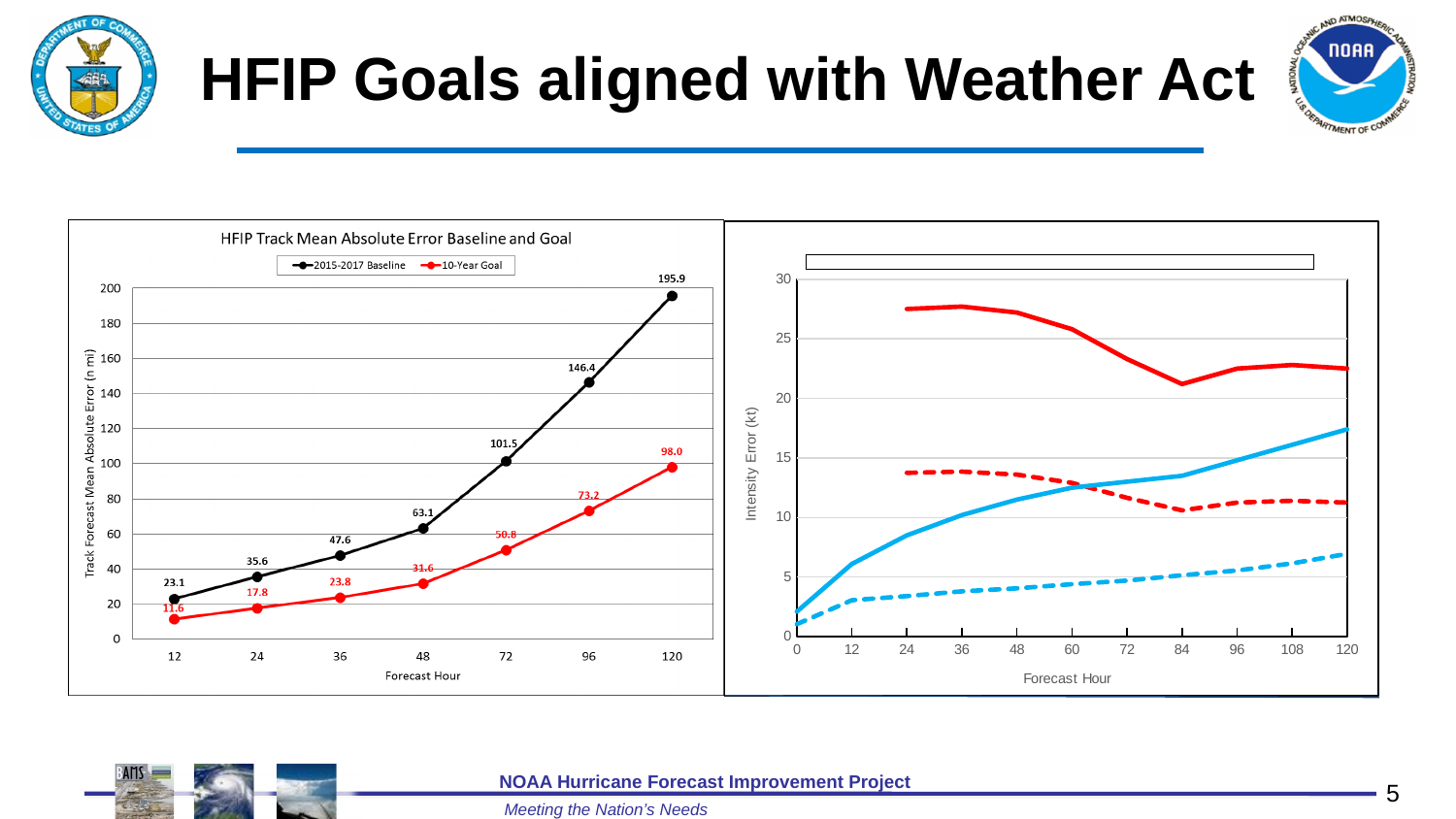
On the left chart titled 'HFIP Track Mean Absolute Error Baseline and Goal', does the 2015-2017 Baseline rise or fall as the forecast hour increases? rise On the left chart titled 'HFIP Track Mean Absolute Error Baseline and Goal', which is larger at forecast hour 96: the 2015-2017 Baseline or the 10-Year Goal? 2015-2017 Baseline On the left chart titled 'HFIP Track Mean Absolute Error Baseline and Goal', how many series does the legend list? 2 On the left chart titled 'HFIP Track Mean Absolute Error Baseline and Goal', at which forecast hour is the 10-Year Goal value lowest? 12 What is the y-axis label of the right-hand chart? Intensity Error (kt) On the left chart titled 'HFIP Track Mean Absolute Error Baseline and Goal', at which forecast hour is the 2015-2017 Baseline value highest? 120 On the left chart titled 'HFIP Track Mean Absolute Error Baseline and Goal', what is the difference between the 2015-2017 Baseline and the 10-Year Goal at forecast hour 12? 11.5 On the left chart titled 'HFIP Track Mean Absolute Error Baseline and Goal', what is the 10-Year Goal value at forecast hour 72? 50.8 On the left chart titled 'HFIP Track Mean Absolute Error Baseline and Goal', what is the 2015-2017 Baseline value at forecast hour 120? 195.9 On the left chart titled 'HFIP Track Mean Absolute Error Baseline and Goal', what is the difference between the 2015-2017 Baseline and the 10-Year Goal at forecast hour 120? 97.9 On the left chart titled 'HFIP Track Mean Absolute Error Baseline and Goal', what is the 2015-2017 Baseline value at forecast hour 48? 63.1 On the left chart titled 'HFIP Track Mean Absolute Error Baseline and Goal', how many forecast hours are plotted on the x axis? 7